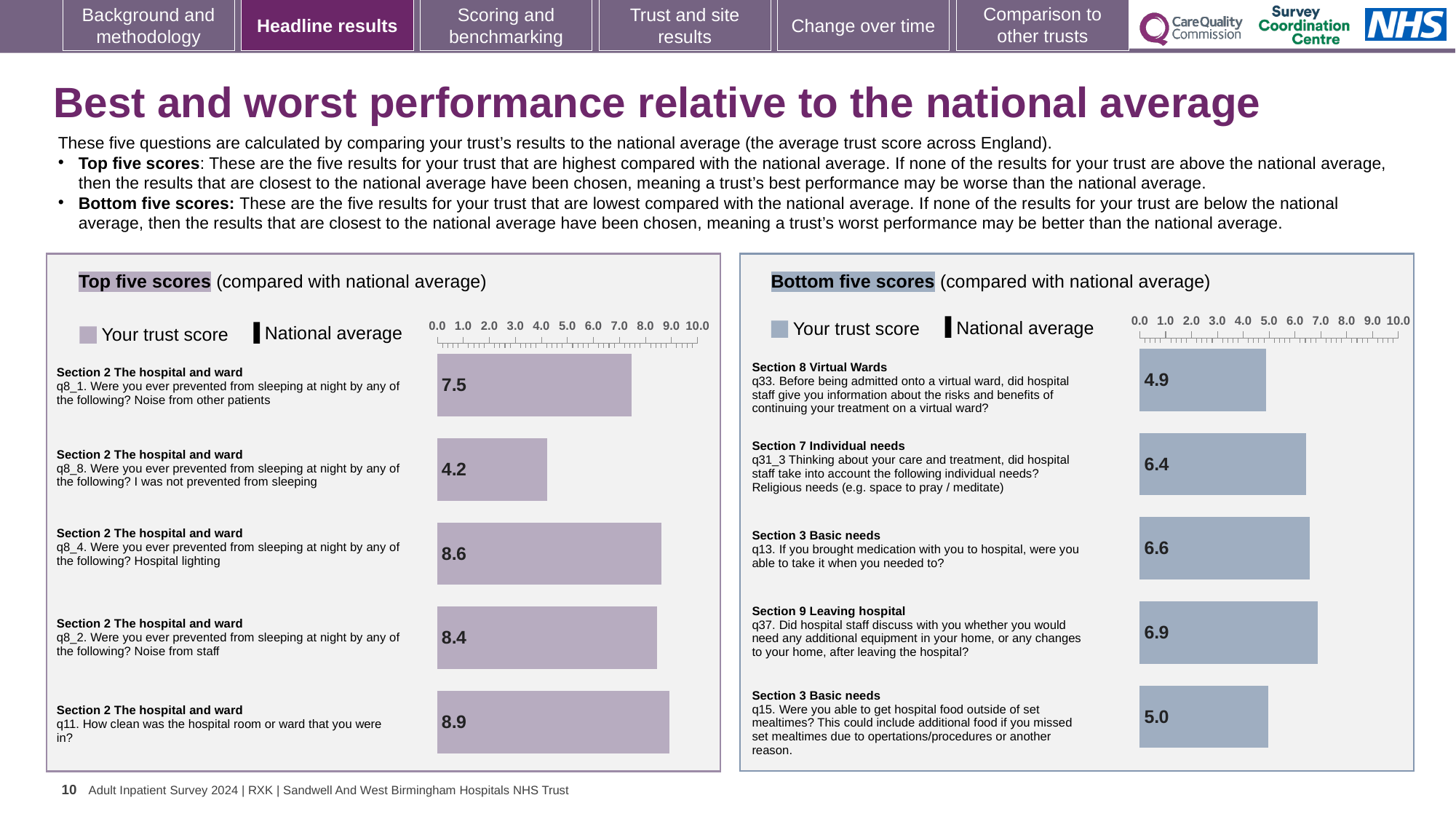
In the Bottom five scores chart, which has the larger trust score: q13 (taking medication you brought) or q31_3 (religious needs)? q13 (taking medication you brought) In the Bottom five scores chart, what is the difference between the trust score for q37 (additional equipment at home) and q15 (food outside set mealtimes)? 1.9 In the Top five scores chart, which question has the highest trust score? q11. How clean was the hospital room or ward that you were in? What two entries does the legend of the Top five scores chart list? Your trust score and National average What type of chart is used in the Bottom five scores panel? Bar chart In the Bottom five scores chart, which question has the highest trust score? q37. Did hospital staff discuss with you whether you would need any additional equipment in your home, or any changes to your home, after leaving the hospital? In the Top five scores chart, what is the trust score for q11 'How clean was the hospital room or ward that you were in?' 8.9 In the Top five scores chart, which question has the lowest trust score? q8_8. I was not prevented from sleeping In the Top five scores chart, what is the difference between the trust score for q11 (cleanliness) and q8_8 (not prevented from sleeping)? 4.7 How many questions are plotted in the Top five scores chart? 5 In the Bottom five scores chart, which question has the lowest trust score? q33. Before being admitted onto a virtual ward, did hospital staff give you information about the risks and benefits of continuing your treatment on a virtual ward? In the Bottom five scores chart, what is the trust score for q33 about information on the risks and benefits of continuing treatment on a virtual ward? 4.9